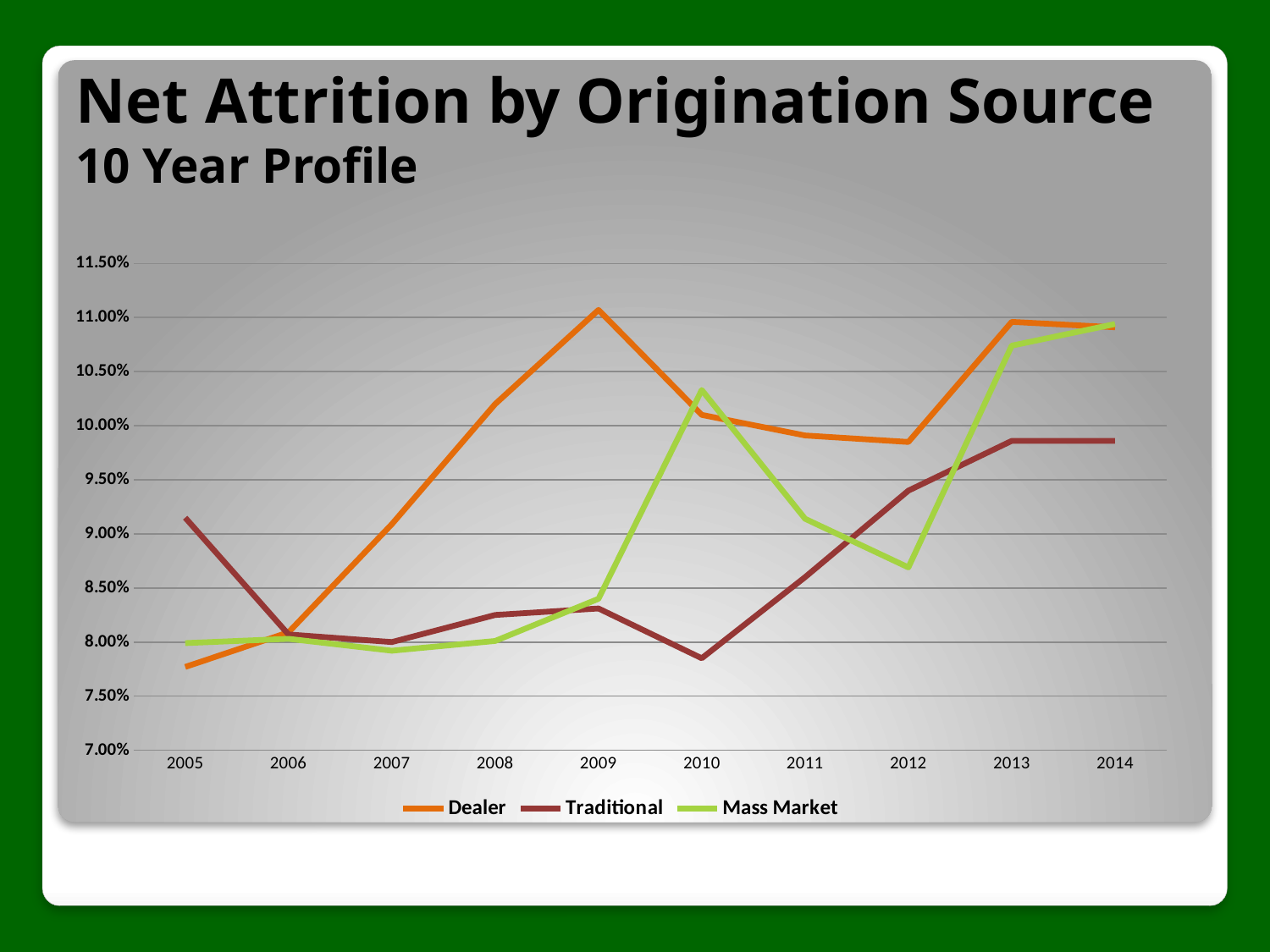
In 2011, which is larger: the Dealer value or the Mass Market value? Dealer Is the Mass Market value for 2012 greater or less than 9.00%? less What kind of chart is shown on the slide? Line chart How many years are shown on the x axis? 10 Does the Traditional series rise or fall from 2010 to 2014? Rise In 2005, which is larger: the Traditional value or the Dealer value? Traditional How many series does the legend list? 3 In which year does the Traditional series reach its lowest value? 2010 In which year does the Dealer series reach its highest value? 2009 Is the Traditional value for 2005 greater or less than 9.00%? greater Is the Dealer value for 2009 greater or less than 10.50%? greater Which series is the lowest in 2005? Dealer